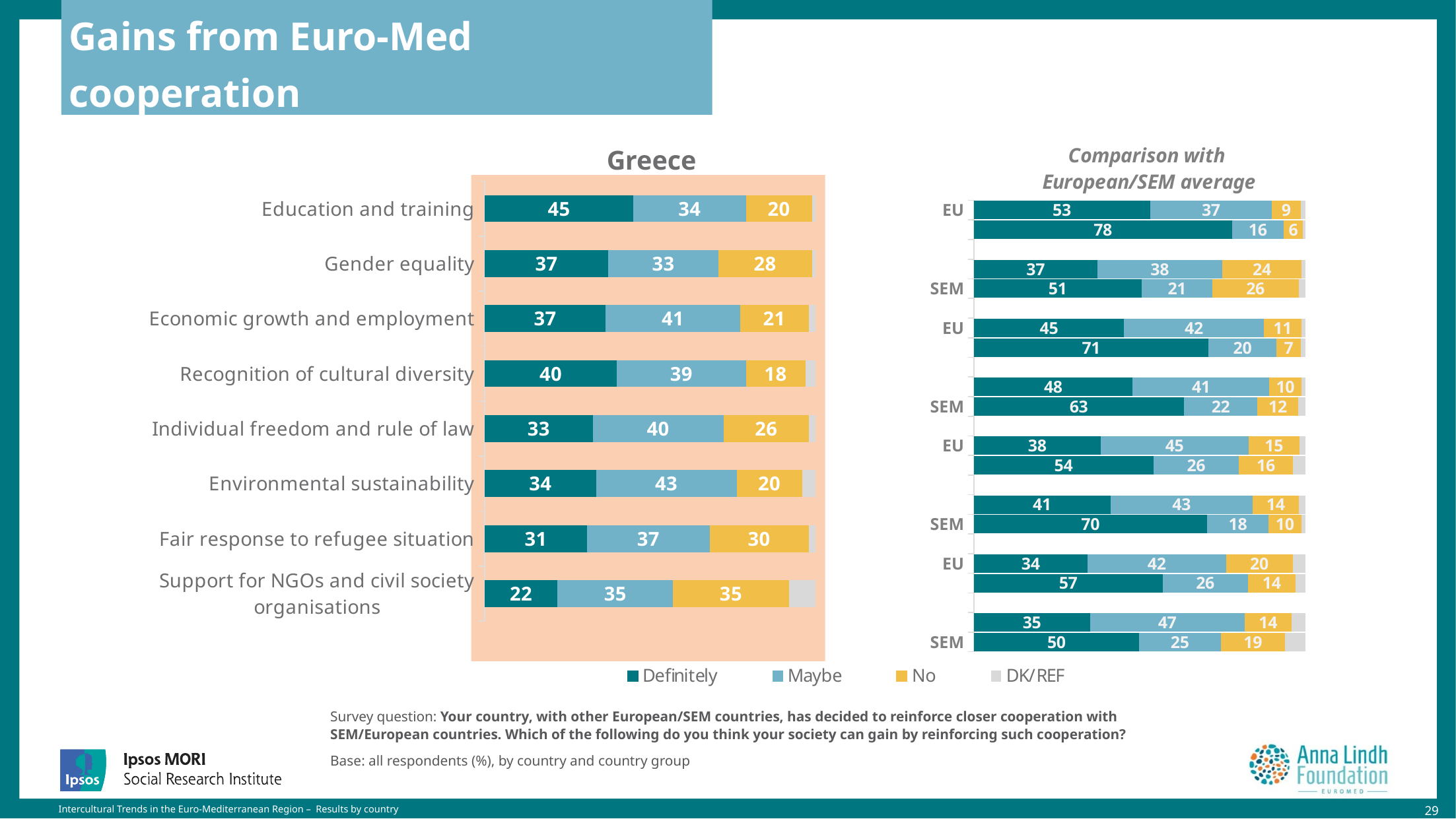
In the Greece chart, what is the total of the 'Definitely', 'Maybe' and 'No' values for Economic growth and employment? 99 How many categories are shown in the Greece chart? 8 What kind of chart is the Greece chart? Stacked bar chart In the Greece chart, what is the 'Maybe' value for Environmental sustainability? 43 In the Greece chart, what is the 'Definitely' value for Education and training? 45 In the Greece chart, which is larger: the 'No' value for Fair response to refugee situation or the 'No' value for Gender equality? Fair response to refugee situation In the Comparison with European/SEM average chart, what is the 'Definitely' value in the first EU bar at the top? 53 How many series does the legend list? 4 In the Greece chart, what is the 'No' value for Support for NGOs and civil society organisations? 35 In the Greece chart, what is the difference between the 'Definitely' values for Education and training and Gender equality? 8 In the Greece chart, which category has the highest 'Definitely' value? Education and training In the Greece chart, which category has the lowest 'Definitely' value? Support for NGOs and civil society organisations